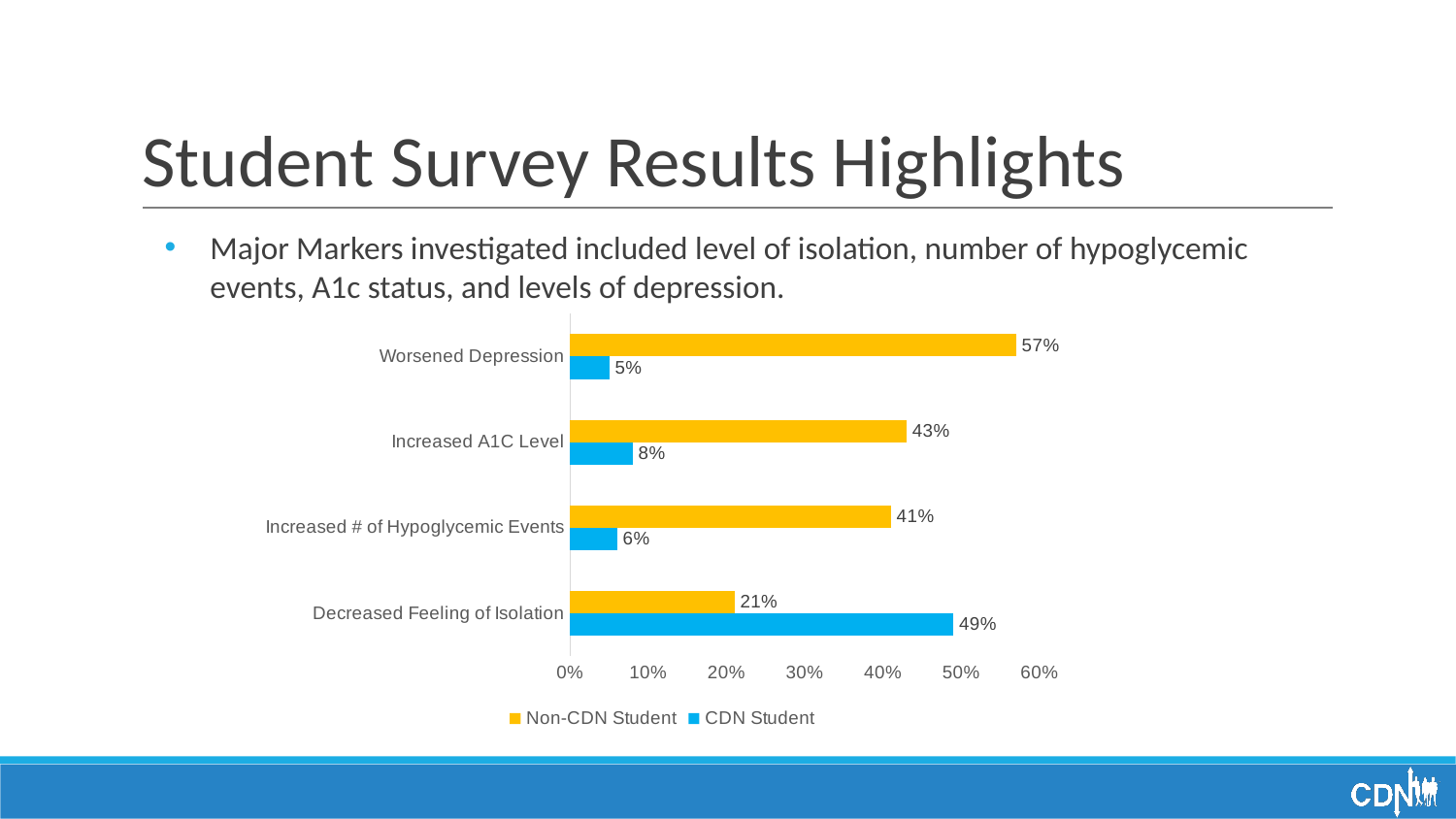
For Decreased Feeling of Isolation, which series has the larger value, Non-CDN Student or CDN Student? CDN Student What kind of chart is shown on the slide? Bar chart Which category has the highest Non-CDN Student value? Worsened Depression What is the difference between the Non-CDN Student and CDN Student values for Worsened Depression? 52% Which category has the lowest CDN Student value? Worsened Depression What is the Non-CDN Student value for Worsened Depression? 57% What is the Non-CDN Student value for Increased # of Hypoglycemic Events? 41% What colour represents the CDN Student series? Blue How many categories are shown on the chart? 4 What is the CDN Student value for Decreased Feeling of Isolation? 49% How many series does the legend list? 2 What is the CDN Student value for Increased A1C Level? 8%